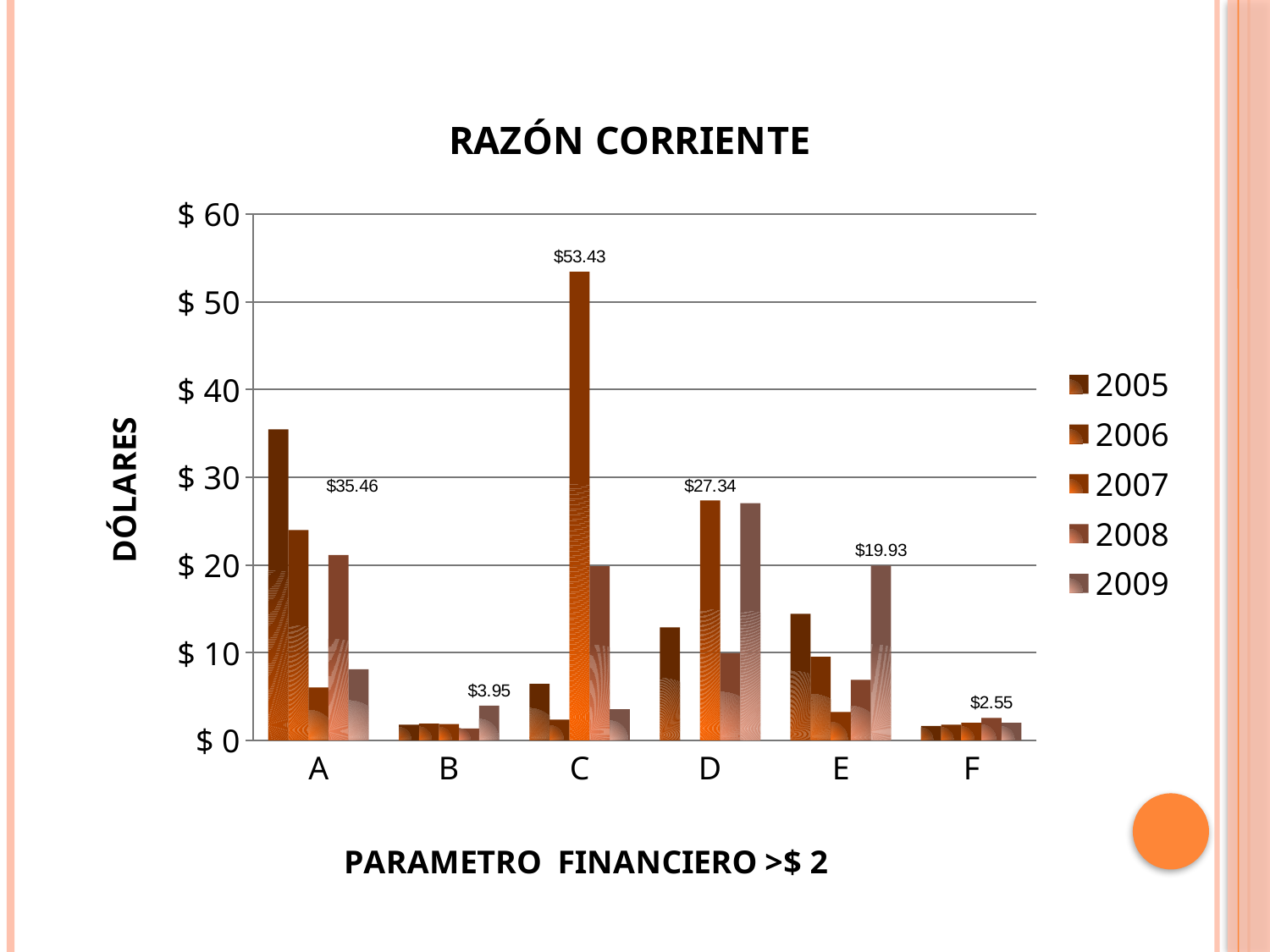
Which category contains the tallest bar in the chart? C How many series does the legend list? 5 What is the title of the y axis? DÓLARES What value is printed as the data label in category E? $19.93 In category E, which is larger, the 2005 bar or the 2006 bar? 2005 What value is printed as the data label in category F? $2.55 What kind of chart is shown on the slide? bar chart What is the difference between the labeled value in category C ($53.43) and the labeled value in category A ($35.46)? $17.97 What value is printed as the data label in category B? $3.95 Is the 2005 bar for category A greater or less than $30? greater How many categories are shown on the x axis? 6